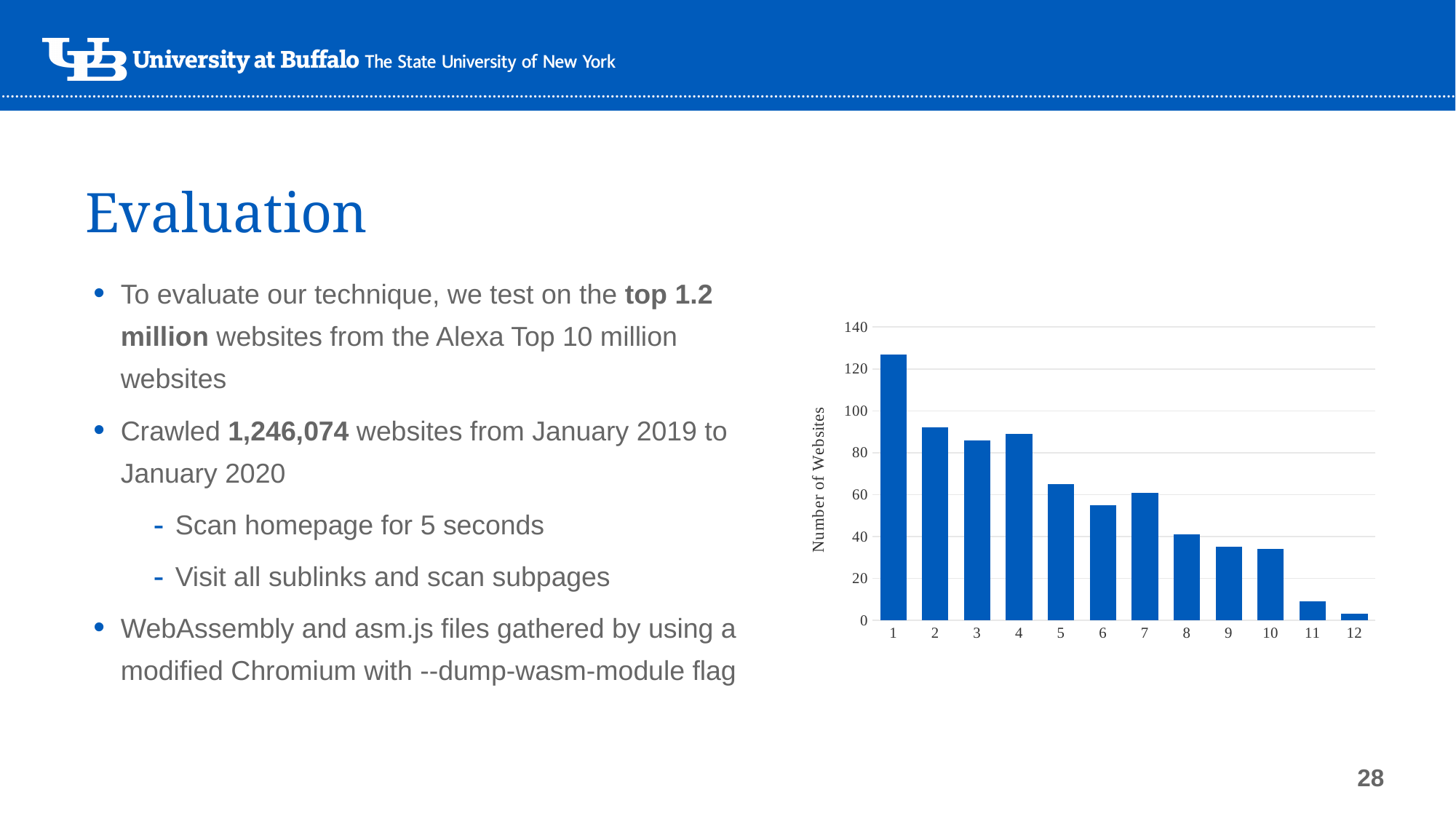
Do the values generally rise or fall from category 1 to category 12? fall Which category has the highest value in the chart? 1 Which has a larger value, category 1 or category 2? 1 What is the label on the vertical axis of the chart? Number of Websites Which category has the lowest value in the chart? 12 Which has a larger value, category 6 or category 7? 7 Is the value for category 1 greater or less than 120? greater How many bars (categories) does the chart show? 12 What kind of chart is shown on the slide? bar chart Is the value for category 11 greater or less than 20? less Is the value for category 5 greater or less than 60? greater